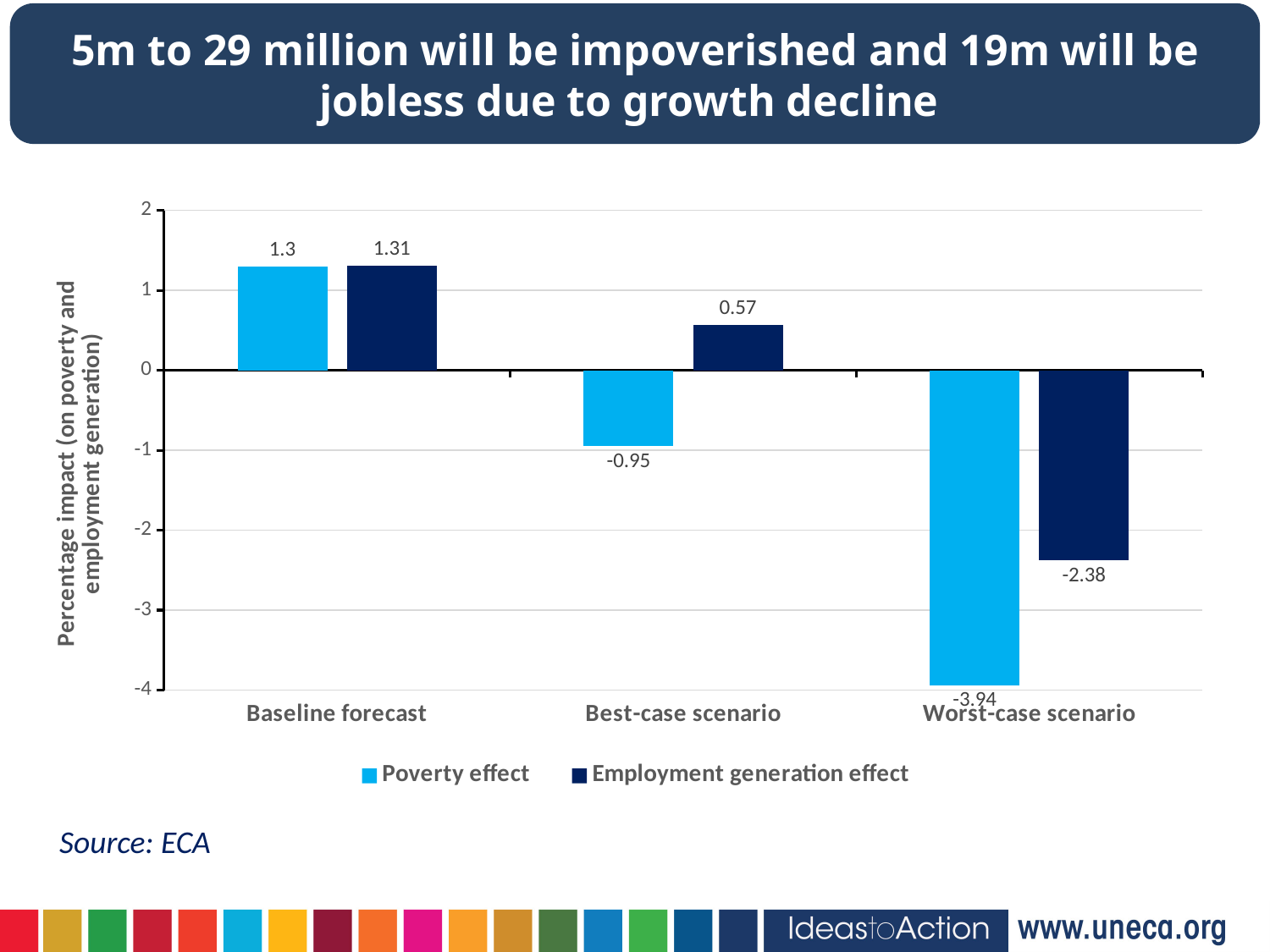
How many series does the legend list? 2 What is the difference between the Poverty effect and the Employment generation effect for the Worst-case scenario? 1.56 For the Best-case scenario, which is larger: the Poverty effect or the Employment generation effect? Employment generation effect What is the Poverty effect value for the Worst-case scenario? -3.94 What is the Employment generation effect value for the Worst-case scenario? -2.38 Which scenario has the lowest Poverty effect value? Worst-case scenario What kind of chart is shown on the slide? Bar chart How many scenarios are shown on the x axis? 3 Is the Poverty effect value for the Best-case scenario greater or less than -1? greater Which scenario has the highest Employment generation effect value? Baseline forecast What is the Poverty effect value for the Baseline forecast? 1.3 What is the Employment generation effect value for the Best-case scenario? 0.57